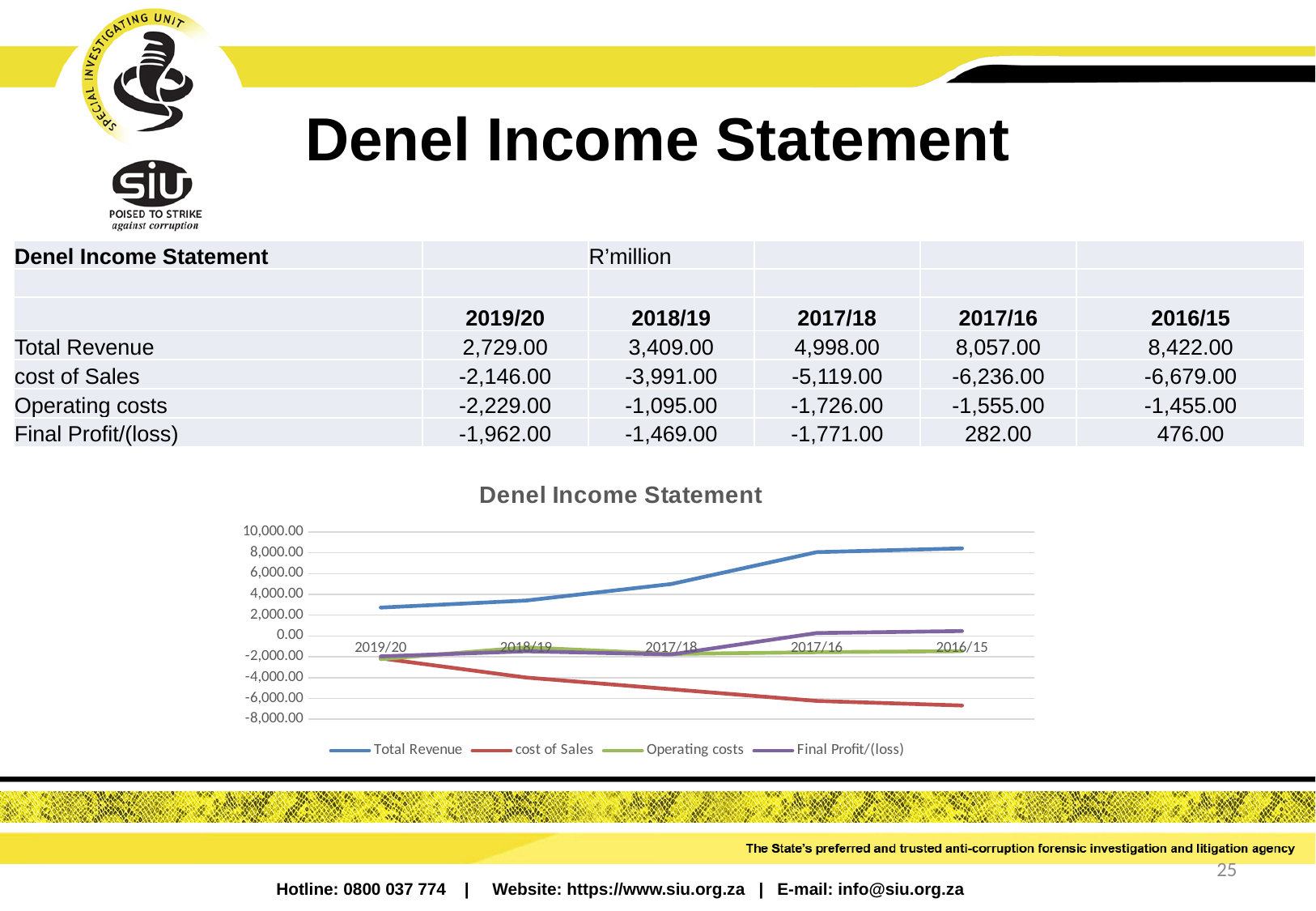
How many financial years are plotted along the x axis of the chart? 5 Which financial year has the lowest Total Revenue in the chart? 2019/20 What is the title of the chart? Denel Income Statement Is the cost of Sales value for 2016/15 greater or less than -6,000.00? less What kind of chart is shown on the slide? line chart Which is larger, Total Revenue in 2017/18 or Total Revenue in 2018/19? 2017/18 What is the Total Revenue for 2019/20 shown on the slide? 2,729.00 How many series does the chart legend list? 4 Is the Total Revenue value for 2017/16 greater or less than 6,000.00? greater What is the difference between Total Revenue in 2016/15 and Total Revenue in 2019/20? 5,693.00 Which financial year has the highest Total Revenue in the chart? 2016/15 Does Total Revenue rise or fall moving from 2019/20 to 2016/15 along the x axis? rise